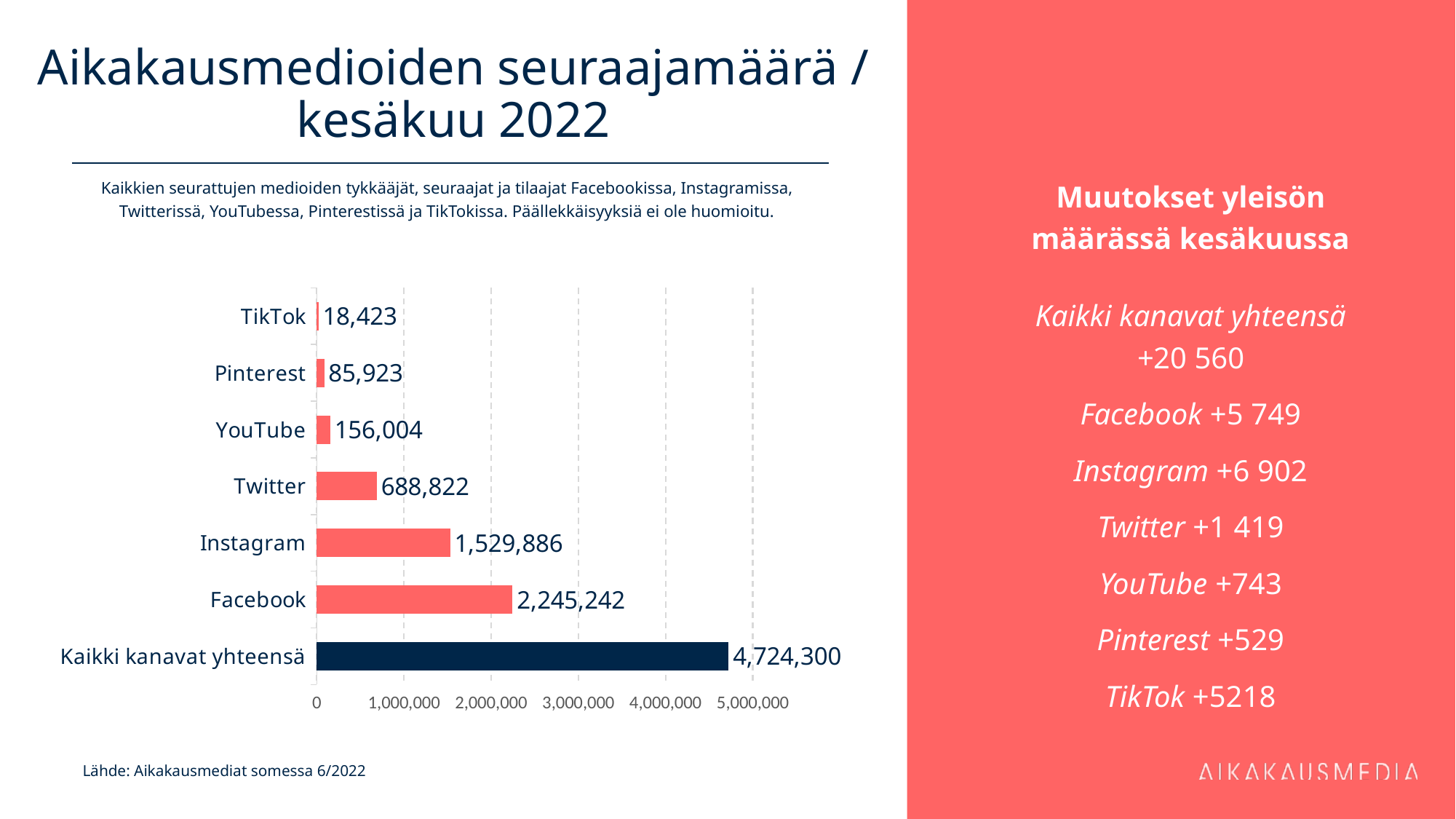
Which has a larger value in the bar chart, Twitter or YouTube? Twitter What is the value shown for Instagram in the bar chart? 1,529,886 What is the difference between the Facebook and Instagram values in the bar chart? 715,356 What kind of chart is shown on the slide? Bar chart What is the value shown for Kaikki kanavat yhteensä in the bar chart? 4,724,300 Which category has the lowest value in the bar chart? TikTok What is the value shown for Facebook in the bar chart? 2,245,242 Which category has the highest value in the bar chart? Kaikki kanavat yhteensä Is the value for Facebook greater or less than 2,000,000? greater What is the value shown for TikTok in the bar chart? 18,423 What is the difference between the Twitter and YouTube values in the bar chart? 532,818 How many categories are shown in the bar chart? 7